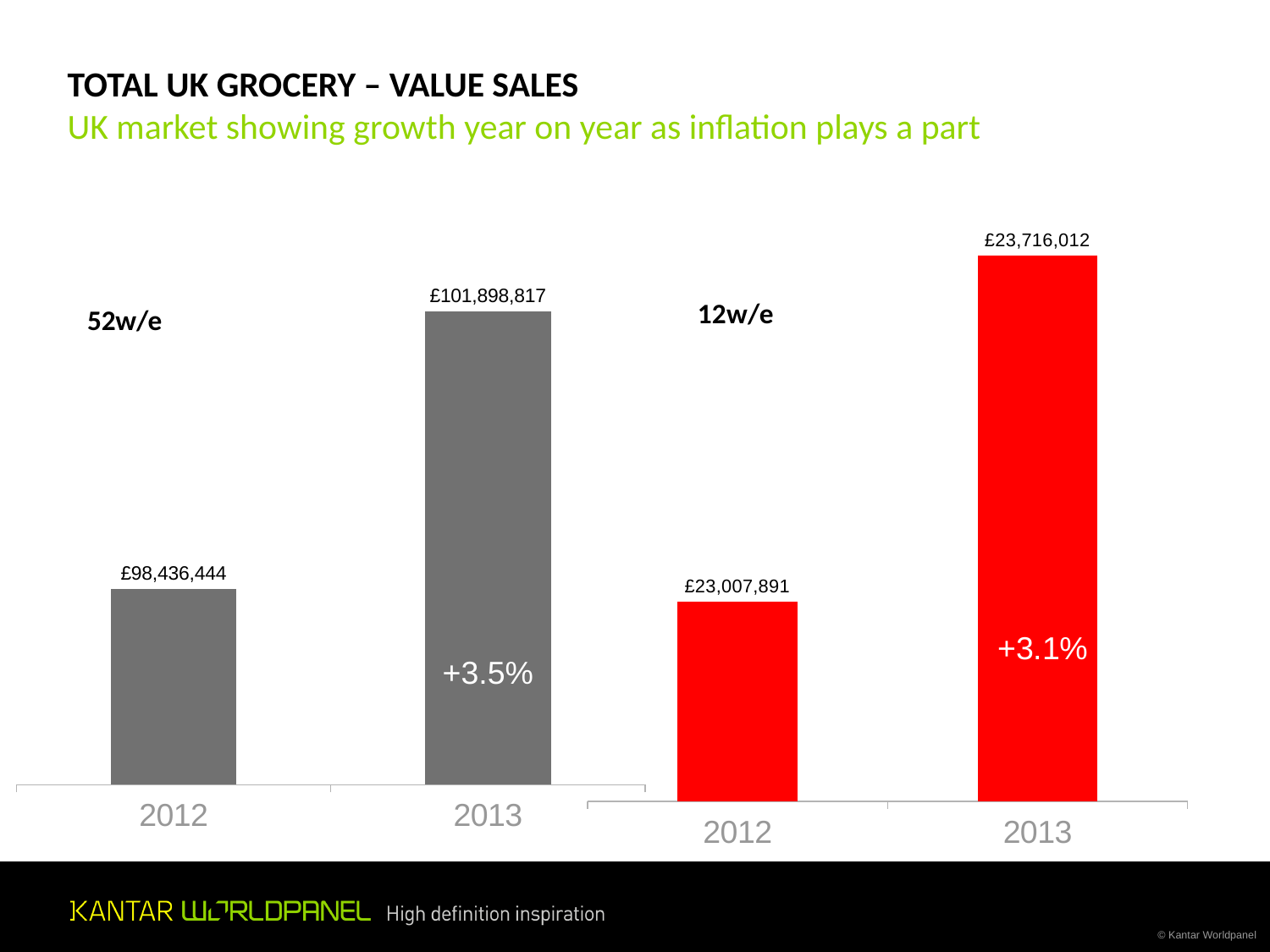
In the 52w/e chart on the left, what is the value for 2013? £101,898,817 In the 12w/e chart on the right, what percentage growth is printed on the 2013 bar? +3.1% What kind of chart is the 12w/e chart on the right? Bar chart In the 12w/e chart on the right, what is the difference between the 2013 and 2012 values? £708,121 In the 12w/e chart on the right, which year has the lower value? 2012 In the 52w/e chart on the left, what is the value for 2012? £98,436,444 In the 52w/e chart on the left, what percentage growth is printed on the 2013 bar? +3.5% In the 52w/e chart on the left, what is the difference between the 2013 and 2012 values? £3,462,373 What colour are the bars in the 12w/e chart on the right? Red In the 12w/e chart on the right, what is the value for 2012? £23,007,891 In the 52w/e chart on the left, which year has the higher value? 2013 In the 12w/e chart on the right, what is the value for 2013? £23,716,012